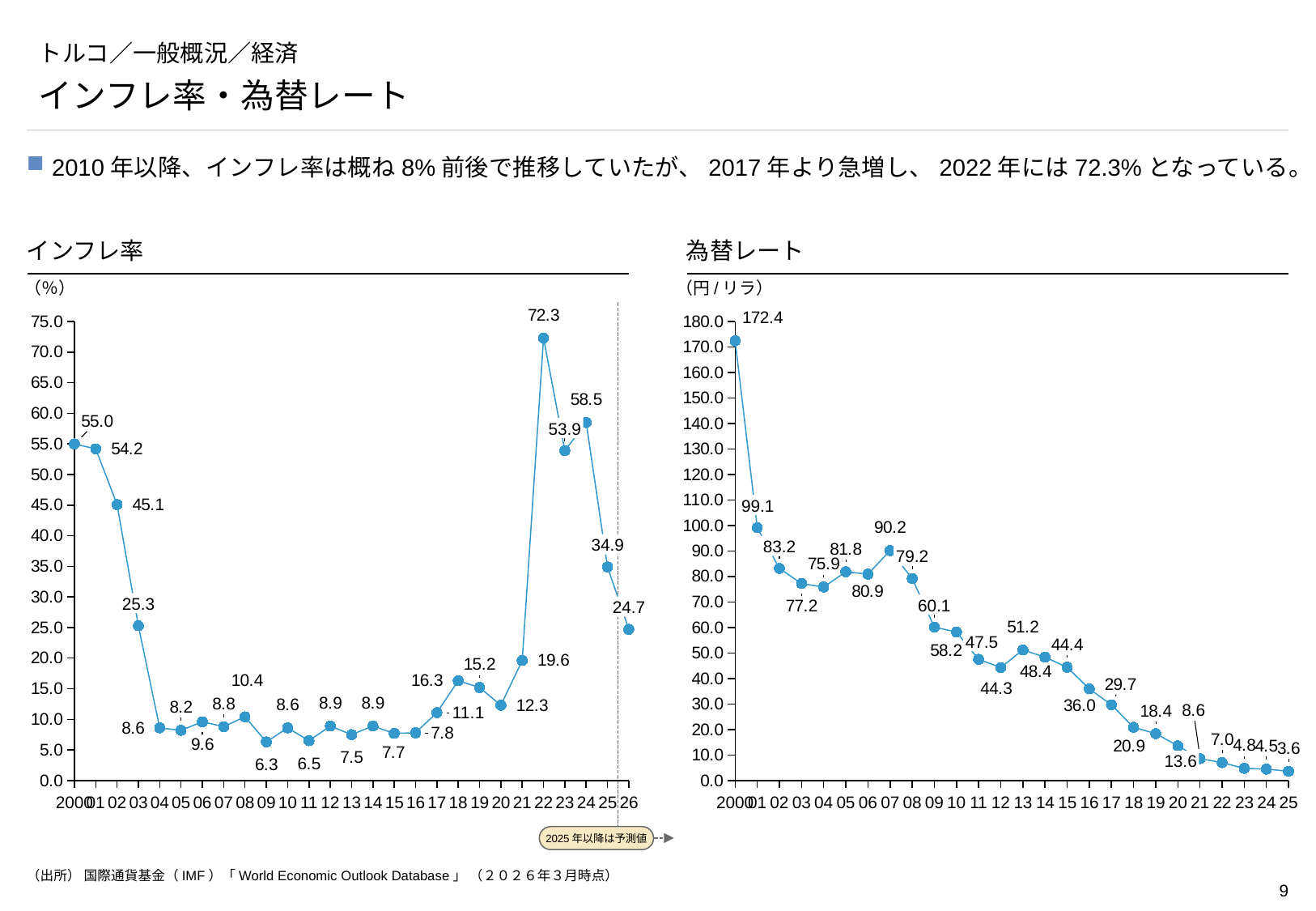
On the 為替レート chart, which is larger, the value for 2007 or the value for 2008? 2007 On the インフレ率 chart, which year has the highest value? 2022 What unit is shown on the y axis of the 為替レート chart? 円/リラ On the インフレ率 chart, what is the difference between the 2022 value and the 2023 value? 18.4 On the 為替レート chart, do the values generally rise or fall from 2009 to 2025? Fall On the 為替レート chart, what is the exchange rate value for 2000? 172.4 On the 為替レート chart, which year has the lowest value? 2025 What kind of chart is the インフレ率 chart? Line chart On the インフレ率 chart, what is the value for 2026? 24.7 On the インフレ率 chart, is the value for 2024 greater or less than 55.0? greater How many data points are plotted on the 為替レート chart? 26 On the インフレ率 chart, what is the inflation rate for 2022? 72.3